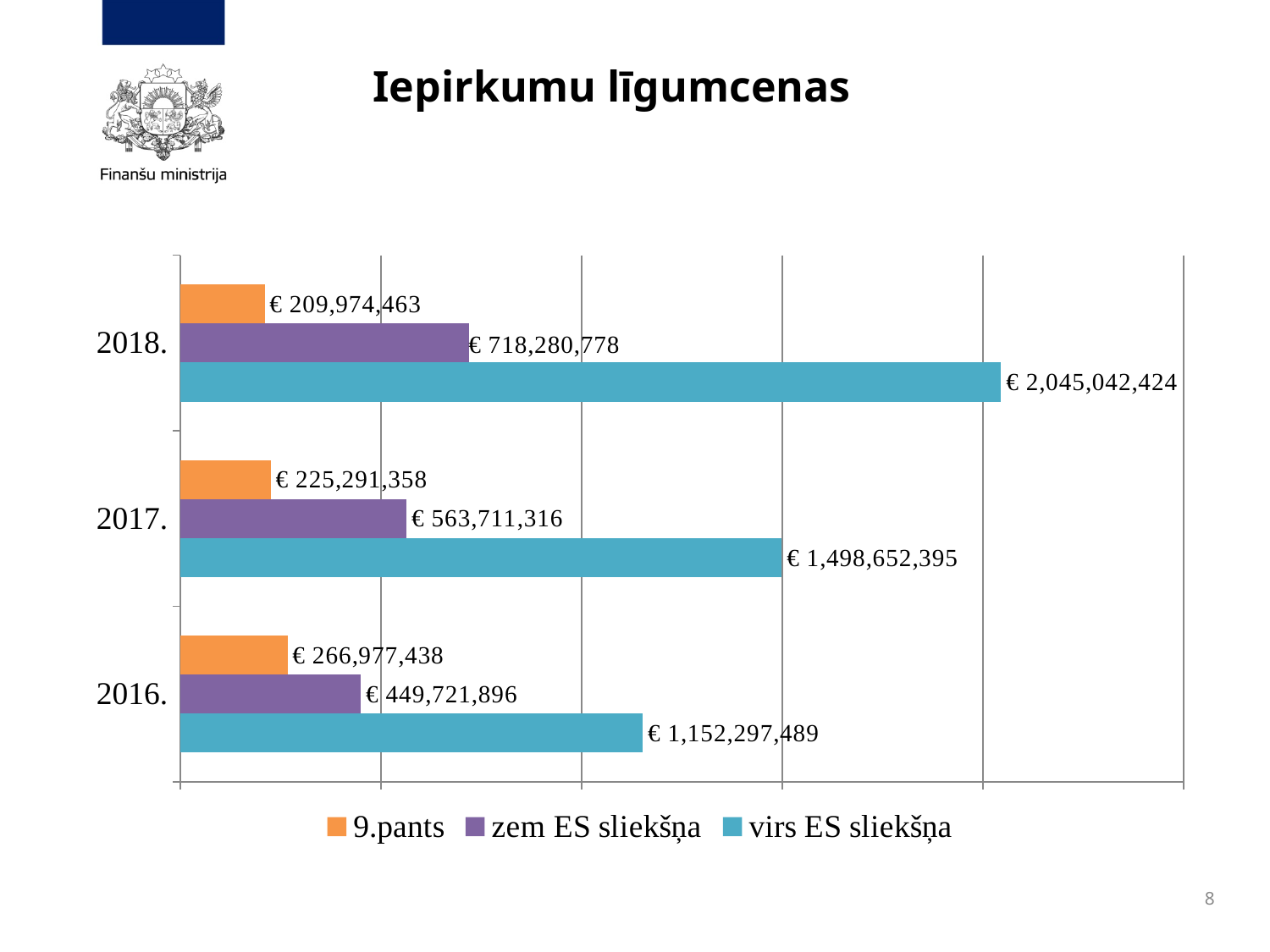
What is the value for 9.pants in 2016? € 266,977,438 Which is larger: zem ES sliekšņa in 2018 or 9.pants in 2016? zem ES sliekšņa in 2018 What is the difference between the zem ES sliekšņa values for 2018 and 2016? € 268,558,882 How many years are shown on the chart? 3 What is the value for zem ES sliekšņa in 2017? € 563,711,316 In which year is the virs ES sliekšņa value highest? 2018. What kind of chart is shown on the slide? bar chart Does the virs ES sliekšņa value rise or fall from 2016 to 2018? rise In which year is the 9.pants value lowest? 2018. What is the difference between the virs ES sliekšņa values for 2018 and 2017? € 546,390,029 What is the value for virs ES sliekšņa in 2018? € 2,045,042,424 How many series does the legend list? 3